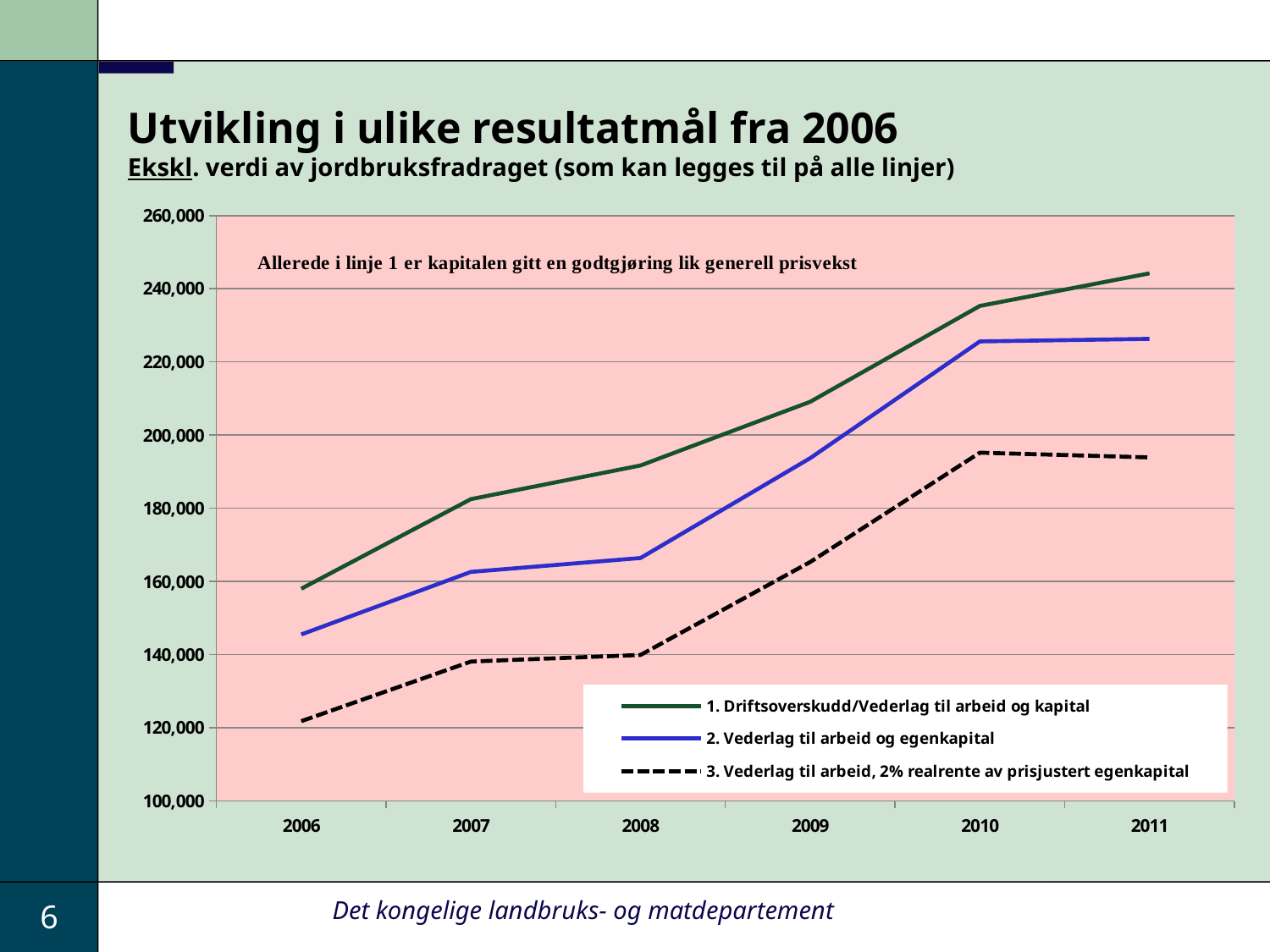
Is the 2009 value for '1. Driftsoverskudd/Vederlag til arbeid og kapital' greater or less than 200,000? greater What kind of chart is shown on the slide? line chart In 2008, which is larger: the value for '1. Driftsoverskudd/Vederlag til arbeid og kapital' or for '3. Vederlag til arbeid, 2% realrente av prisjustert egenkapital'? 1. Driftsoverskudd/Vederlag til arbeid og kapital How many years are shown on the x axis? 6 Which series is drawn with a dashed line? 3. Vederlag til arbeid, 2% realrente av prisjustert egenkapital How many series does the legend list? 3 Does the series '1. Driftsoverskudd/Vederlag til arbeid og kapital' rise or fall from 2006 to 2011? rise Is the 2006 value for '2. Vederlag til arbeid og egenkapital' greater or less than 160,000? less In which year is the series '2. Vederlag til arbeid og egenkapital' lowest? 2006 Is the 2011 value for '1. Driftsoverskudd/Vederlag til arbeid og kapital' greater or less than 240,000? greater In which year is the series '1. Driftsoverskudd/Vederlag til arbeid og kapital' highest? 2011